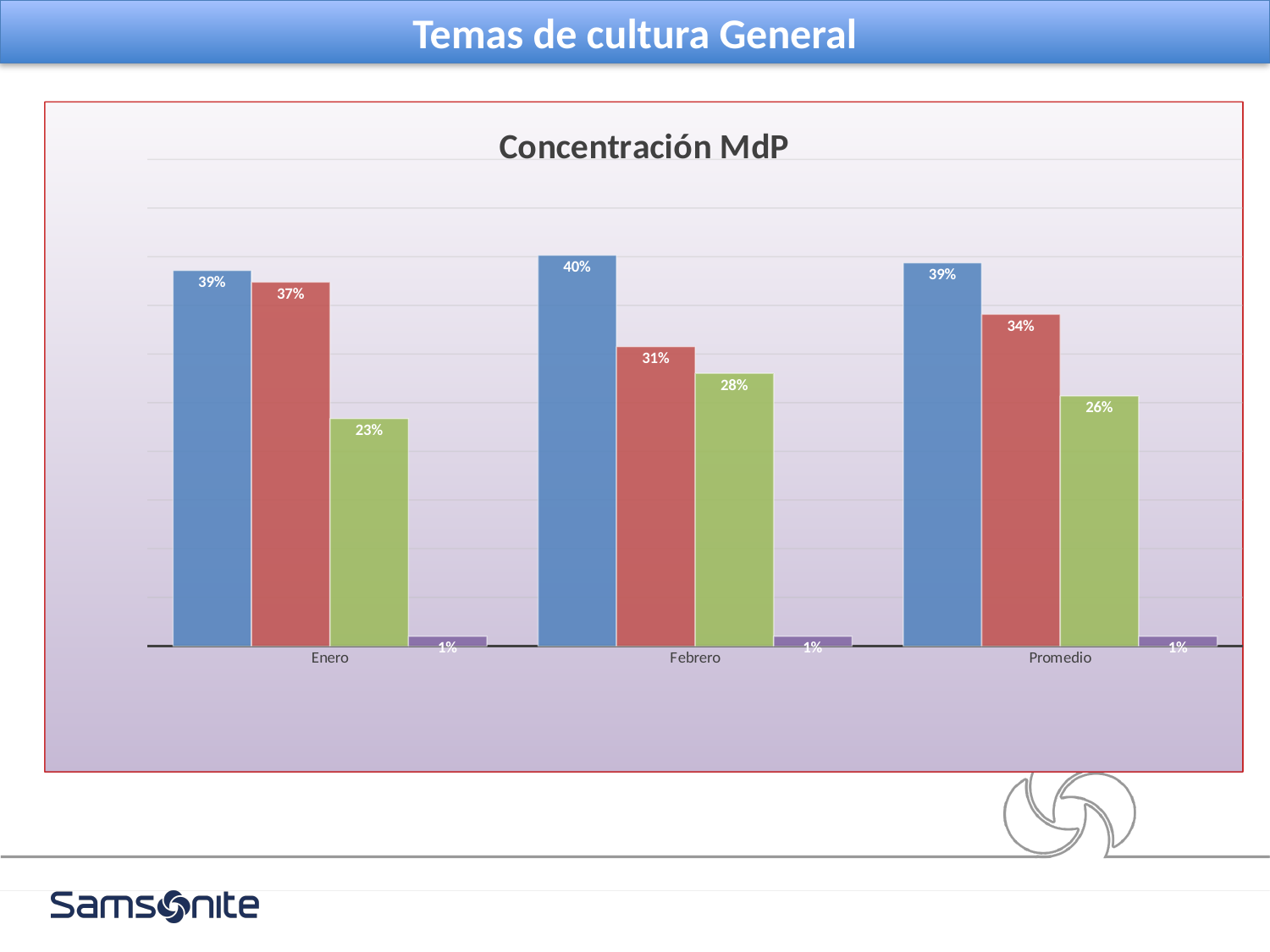
How many categories are shown on the x axis of the chart? 3 What is the value of the green bar for Promedio? 26% What is the value of the blue bar for Febrero? 40% What is the difference between the blue bar and the red bar for Febrero? 9% Does the value of the red bar rise or fall from Enero to Febrero? fall In which category is the red bar lowest? Febrero What is the value of the red bar for Enero? 37% In which category is the green bar highest? Febrero Which is larger for Enero, the red bar or the green bar? the red bar What is the title of the chart? Concentración MdP What is the value of the purple bar for Febrero? 1% What type of chart is shown on the slide? bar chart